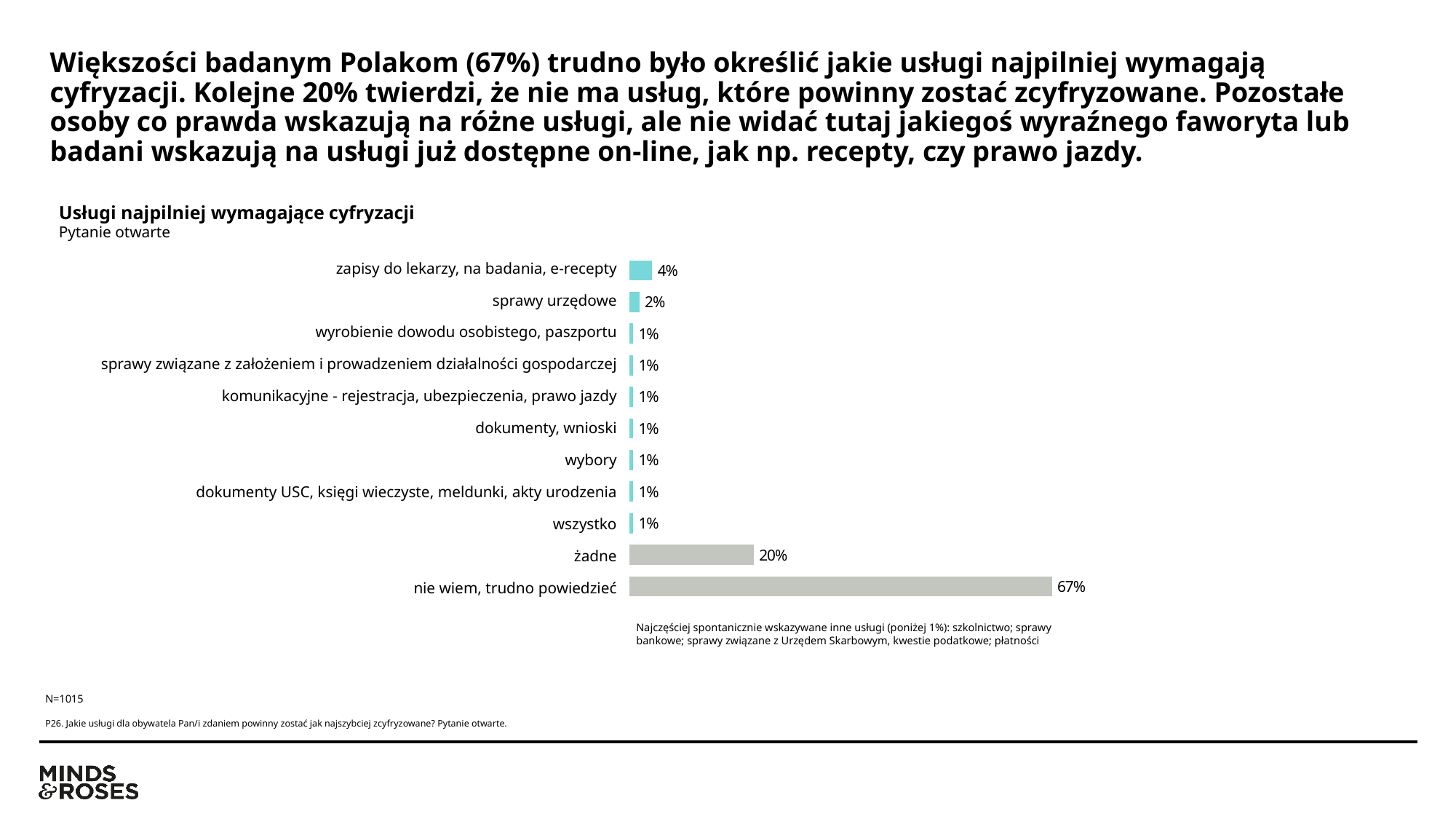
What is the difference between "nie wiem, trudno powiedzieć" and "żadne"? 47% What is the value for "sprawy urzędowe"? 2% What is the value for "wybory"? 1% How many categories are shown in the chart? 11 What is the value for "zapisy do lekarzy, na badania, e-recepty"? 4% What is the difference between "zapisy do lekarzy, na badania, e-recepty" and "sprawy urzędowe"? 2% Which category has the highest value? nie wiem, trudno powiedzieć What kind of chart is shown on the slide? bar chart What is the title of the chart? Usługi najpilniej wymagające cyfryzacji Which is larger, the value for "żadne" or the value for "zapisy do lekarzy, na badania, e-recepty"? żadne What is the value for "żadne"? 20% What is the value for "nie wiem, trudno powiedzieć"? 67%